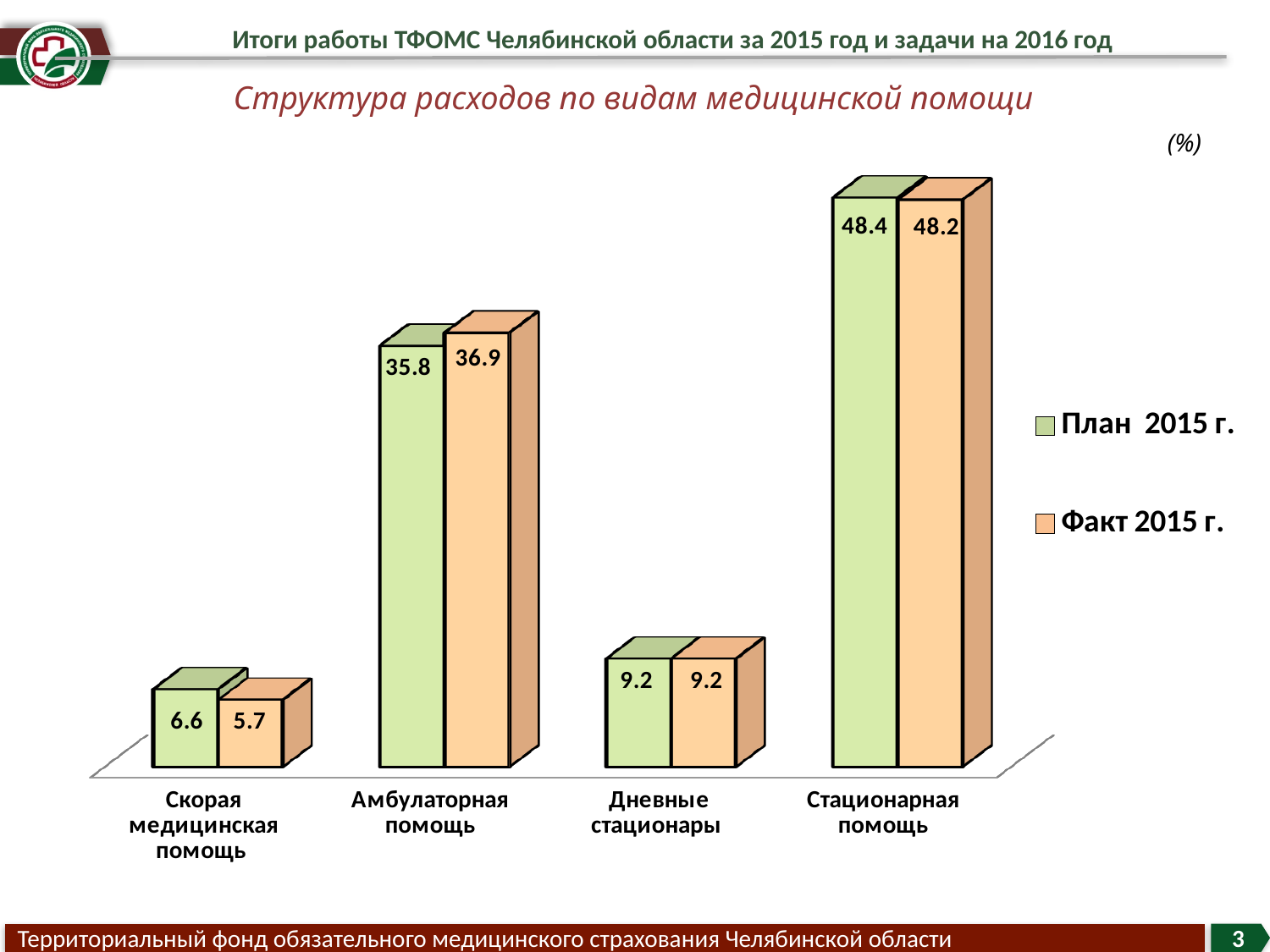
What is the value for Факт 2015 г. for Стационарная помощь? 48.2 What is the difference between the Факт 2015 г. and План 2015 г. values for Амбулаторная помощь? 1.1 What is the value for План 2015 г. for Амбулаторная помощь? 35.8 How many categories are shown on the x axis? 4 What is the difference between the План 2015 г. and Факт 2015 г. values for Скорая медицинская помощь? 0.9 Which category has the lowest value for Факт 2015 г.? Скорая медицинская помощь Which is larger for Амбулаторная помощь: План 2015 г. or Факт 2015 г.? Факт 2015 г. How many series does the legend list? 2 Which category has the highest value for План 2015 г.? Стационарная помощь What is the value for Факт 2015 г. for Скорая медицинская помощь? 5.7 What kind of chart is shown on the slide? Bar chart What is the title of the chart? Структура расходов по видам медицинской помощи